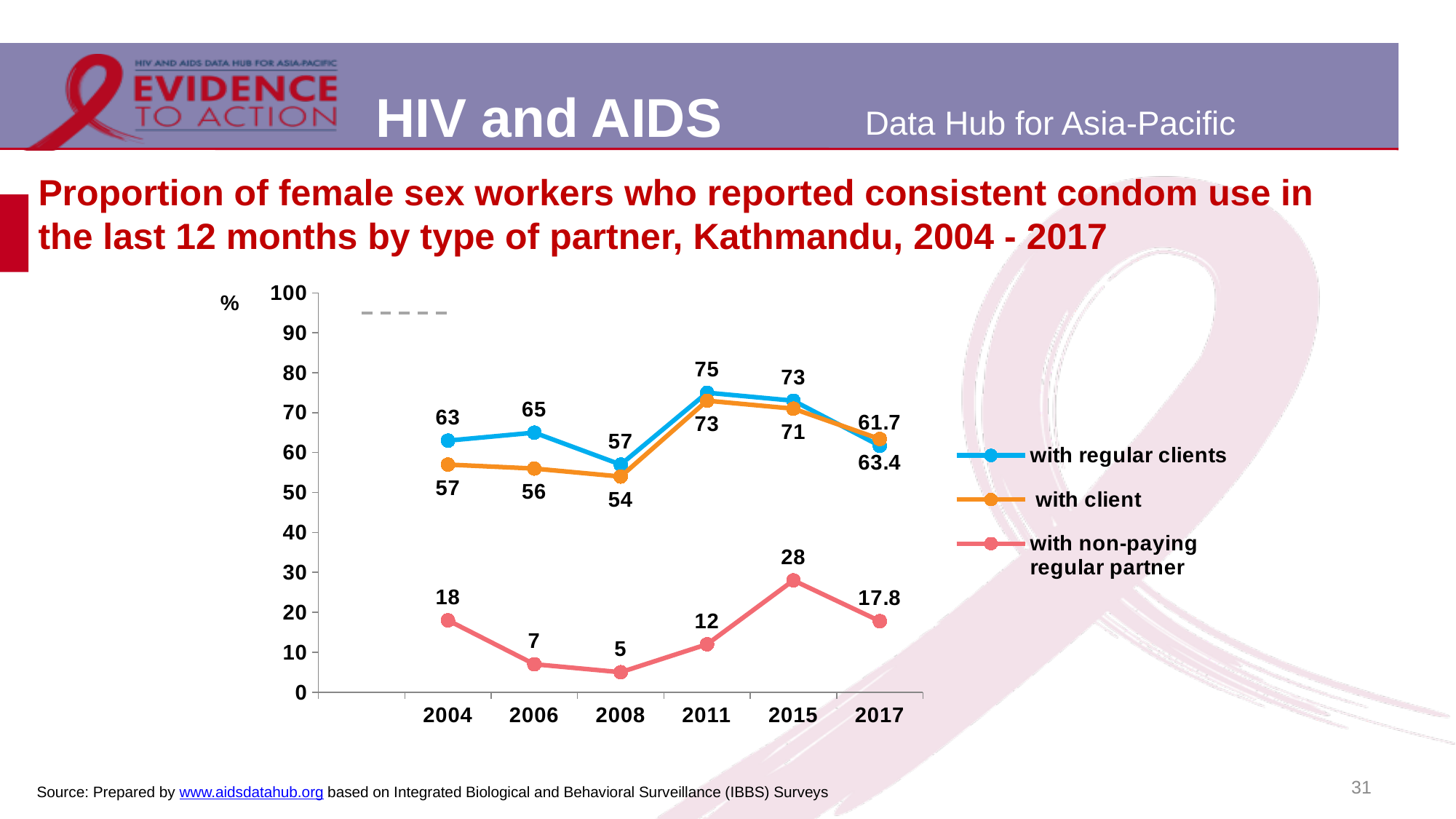
What is the value for 'with regular clients' in 2004? 63 Does the 'with non-paying regular partner' series rise or fall from 2004 to 2008? fall What is the difference between the 'with regular clients' values in 2011 and 2008? 18 In which year is the 'with non-paying regular partner' series lowest? 2008 How many years are shown on the x axis? 6 How many series does the legend list? 3 What kind of chart is shown on the slide? line chart In which year is the 'with non-paying regular partner' series highest? 2015 In 2006, which is larger: 'with regular clients' or 'with client'? with regular clients What is the value for 'with non-paying regular partner' in 2015? 28 What is the value for 'with regular clients' in 2011? 75 What is the value for 'with client' in 2008? 54